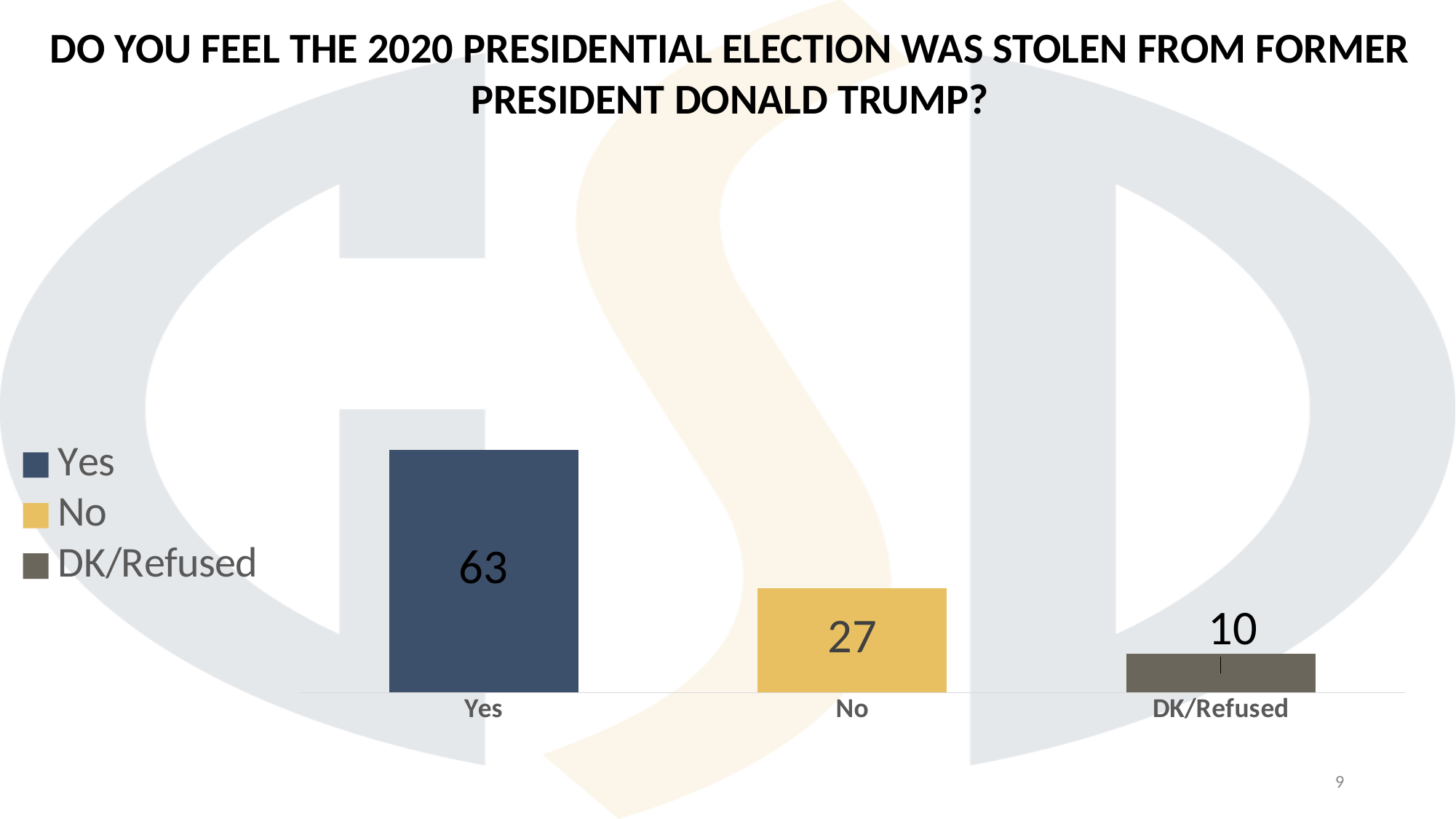
What is the value for Yes? 63 What colour is the bar for No? Yellow Which category has the highest value? Yes What is the difference between the values for Yes and No? 36 Which is larger, the value for No or the value for DK/Refused? No What is the value for No? 27 How many entries does the legend list? 3 Which category has the lowest value? DK/Refused How many categories are shown in the chart? 3 What is the difference between the values for No and DK/Refused? 17 What is the value for DK/Refused? 10 What kind of chart is shown on the slide? Bar chart